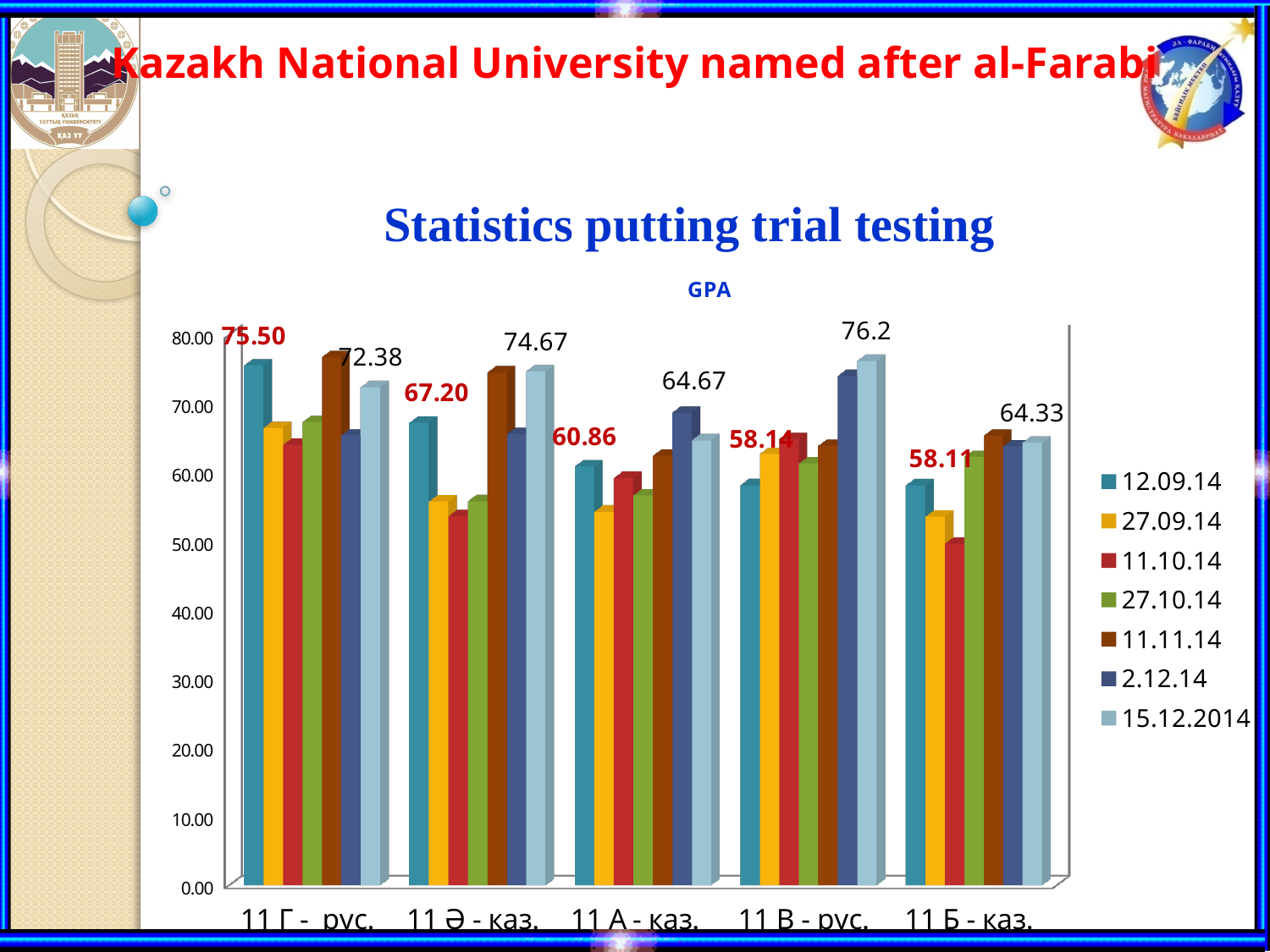
What kind of chart is shown on the slide? bar chart Is the 27.09.14 value for 11 Г - рус. greater or less than 60.00? greater Which category has the highest 12.09.14 value? 11 Г - рус. What is the 12.09.14 value for 11 Б - каз.? 58.11 Do the 12.09.14 values rise or fall from left to right across the categories? fall How many class categories are shown on the x axis of the GPA chart? 5 What is the difference between the 12.09.14 values for 11 Г - рус. and 11 Б - каз.? 17.39 Which has the larger 15.12.2014 value, 11 Ә - каз. or 11 В - рус.? 11 В - рус. How many series does the legend of the GPA chart list? 7 Which category has the lowest 12.09.14 value? 11 Б - каз. What is the 15.12.2014 value for 11 В - рус.? 76.2 What is the 12.09.14 value for 11 Г - рус.? 75.50